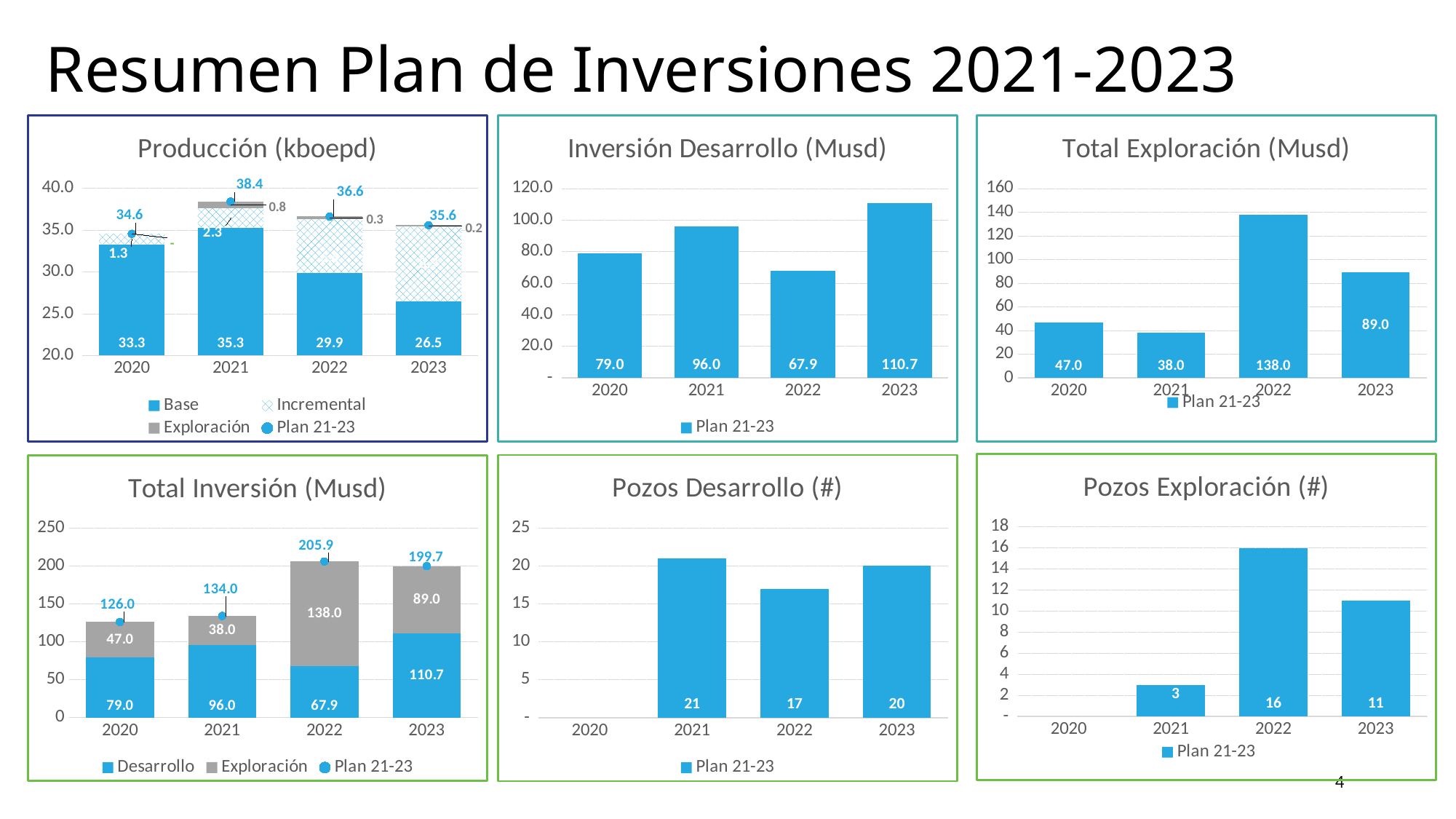
What kind of chart is the Pozos Desarrollo (#) chart? bar chart In the Total Exploración (Musd) chart, which year has the lowest value? 2021 In the Total Inversión (Musd) chart, what is the total of the stacked bar for 2021? 134.0 In the Pozos Desarrollo (#) chart, which is larger, the value for 2021 or the value for 2023? 2021 In the Inversión Desarrollo (Musd) chart, what is the value for 2023? 110.7 In the Pozos Exploración (#) chart, what is the value for 2022? 16 In the Producción (kboepd) chart, how many entries does the legend list? 4 In the Producción (kboepd) chart, what is the Base value for 2023? 26.5 In the Total Inversión (Musd) chart, what is the Plan 21-23 value for 2022? 205.9 In the Inversión Desarrollo (Musd) chart, what is the difference between the 2023 and 2022 values? 42.8 In the Total Exploración (Musd) chart, which year has the highest value? 2022 In the Producción (kboepd) chart, what is the Exploración value for 2021? 0.8